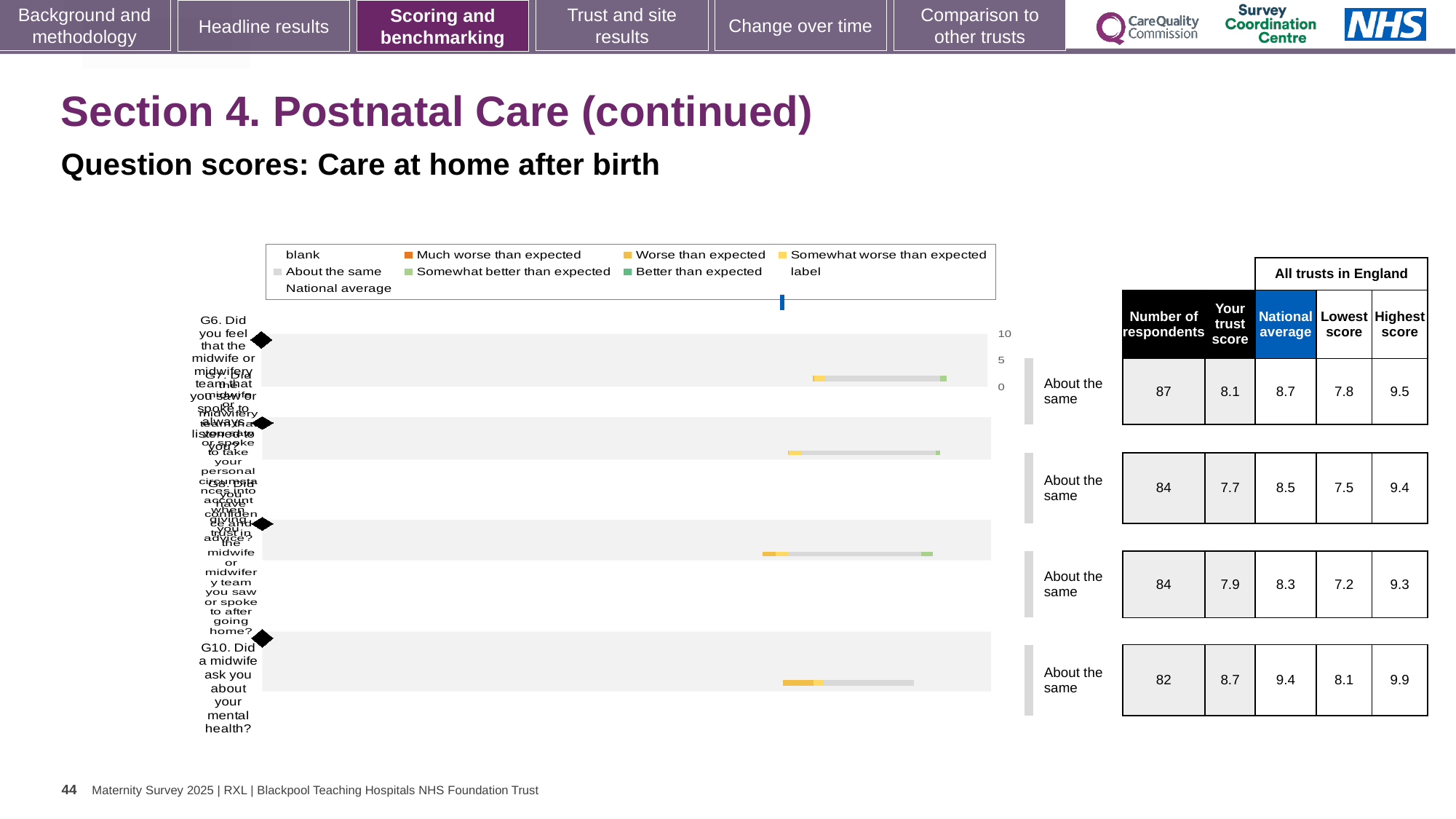
What kind of chart is used to show the question scores for care at home after birth? bar chart How many respondents answered G6? 87 What is the 'Your trust score' for G10 (Did a midwife ask you about your mental health?)? 8.7 What is the national average for G6? 8.7 By how much does the national average for G7 exceed the trust score for G7? 0.8 How many entries does the chart legend list? 9 What is the difference between the highest score and the lowest score for G10? 1.8 Which question has the lowest number of respondents? G10 Which has the larger trust score, G6 or G7? G6 Which question has the highest 'Your trust score'? G10 What benchmark category label is shown next to each of the four questions? About the same How many questions (rows) are plotted in the chart? 4